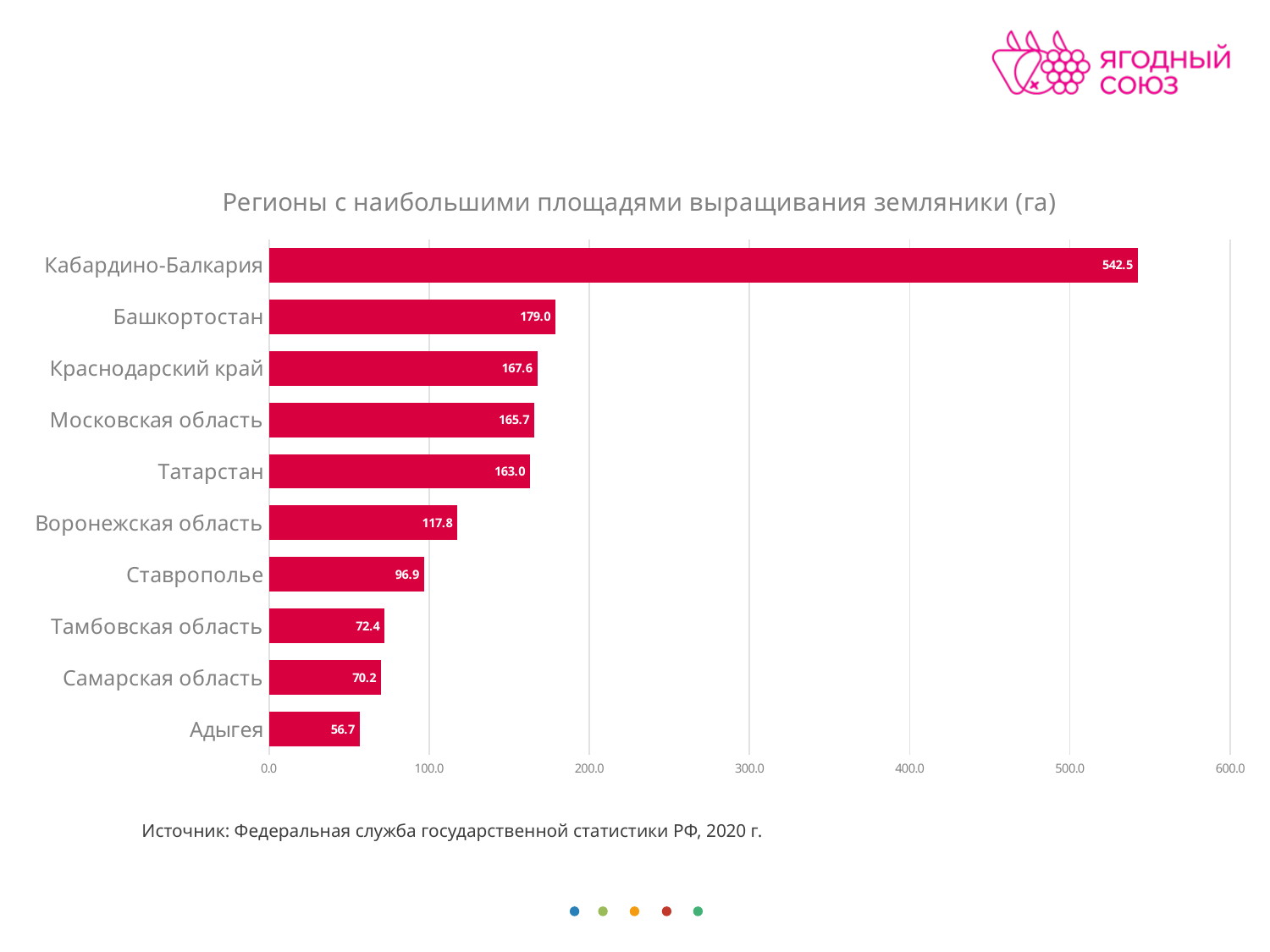
What is the value for Кабардино-Балкария? 542.5 What is the title of the chart? Регионы с наибольшими площадями выращивания земляники (га) What is the value for Московская область? 165.7 What is the difference between the values for Кабардино-Балкария and Башкортостан? 363.5 What kind of chart is shown on the slide? bar chart Is the value for Тамбовская область greater or less than 100.0? less Which region has the lowest value? Адыгея Which is larger, the value for Татарстан or the value for Воронежская область? Татарстан Which region has the highest value? Кабардино-Балкария What is the value for Адыгея? 56.7 What is the difference between the values for Воронежская область and Ставрополье? 20.9 How many regions are shown in the chart? 10